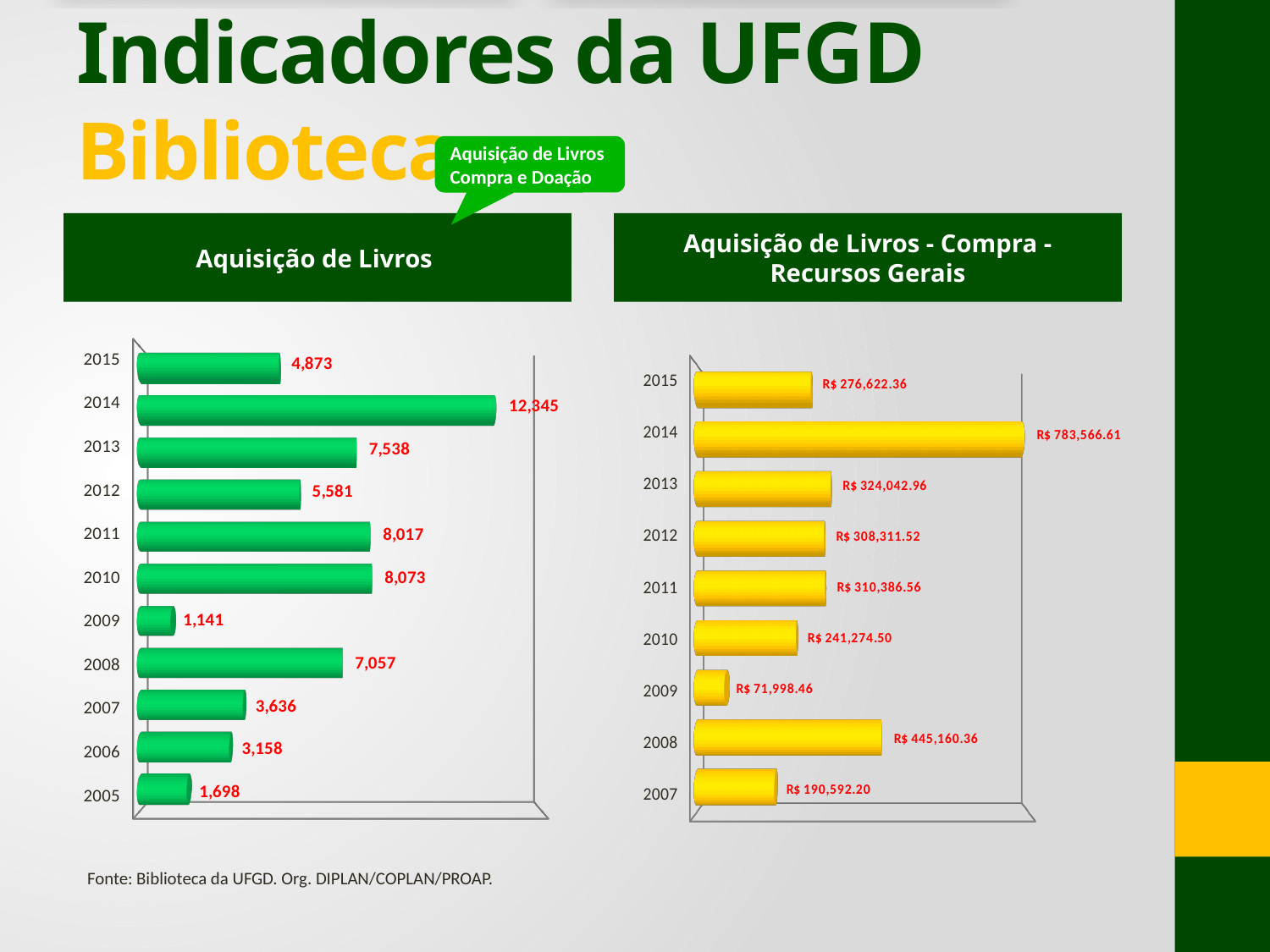
In the 'Aquisição de Livros - Compra - Recursos Gerais' chart, which is larger, the value for 2008 or the value for 2015? 2008 In the 'Aquisição de Livros - Compra - Recursos Gerais' chart, which year has the highest value? 2014 In the 'Aquisição de Livros' chart, what is the difference between the values for 2014 and 2015? 7,472 In the 'Aquisição de Livros - Compra - Recursos Gerais' chart, what is the value for 2013? R$ 324,042.96 In the 'Aquisição de Livros' chart, what is the value for 2014? 12,345 In the 'Aquisição de Livros' chart, how many years are shown? 11 In the 'Aquisição de Livros - Compra - Recursos Gerais' chart, what is the value for 2009? R$ 71,998.46 What kind of chart is the 'Aquisição de Livros - Compra - Recursos Gerais' chart? Bar chart In the 'Aquisição de Livros - Compra - Recursos Gerais' chart, how many years are shown? 9 In the 'Aquisição de Livros' chart, which year has the lowest value? 2009 In the 'Aquisição de Livros' chart, which year has the highest value? 2014 In the 'Aquisição de Livros' chart, what is the value for 2009? 1,141